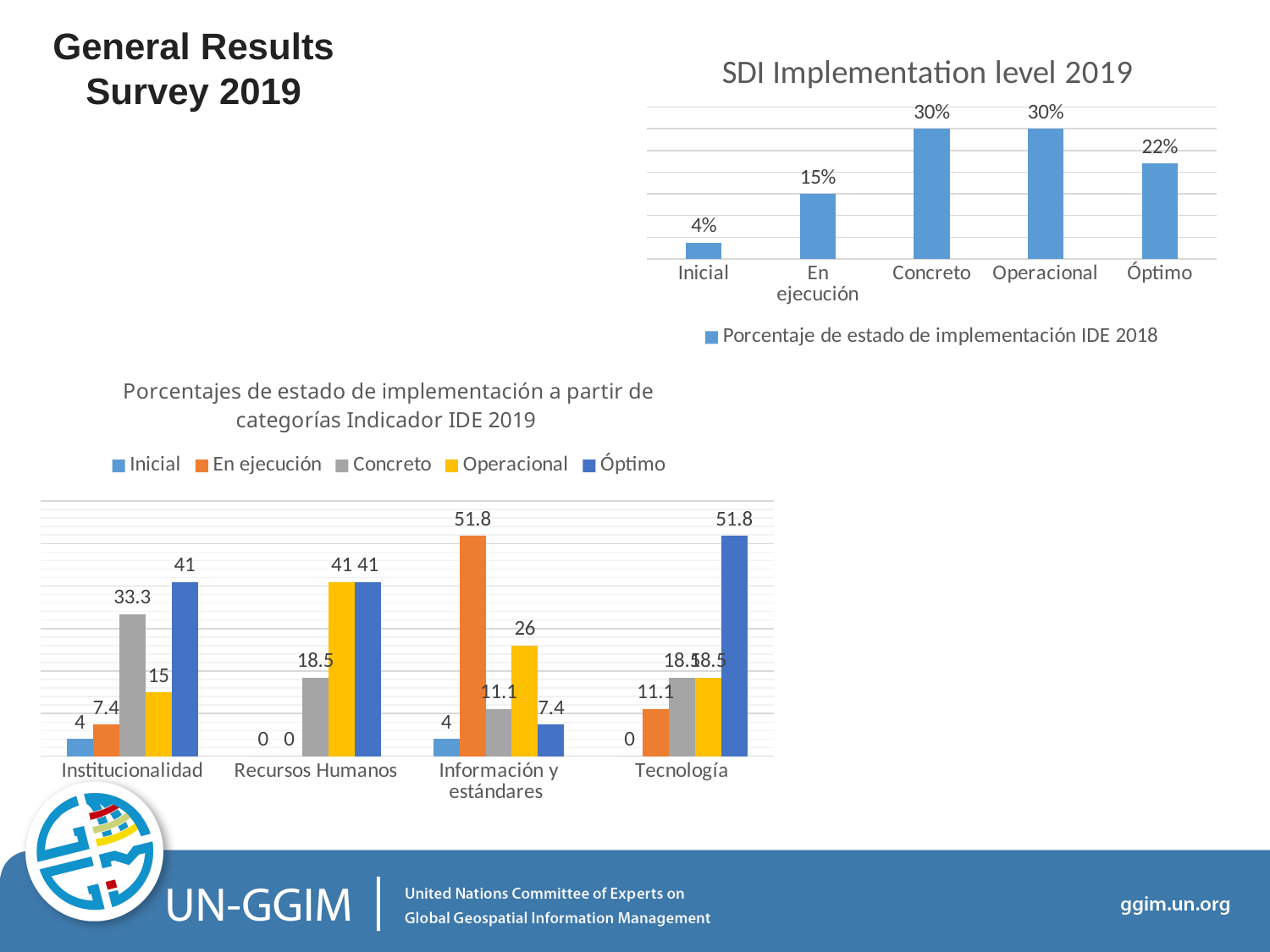
In the 'SDI Implementation level 2019' chart, what is the legend entry? Porcentaje de estado de implementación IDE 2018 In the 'Porcentajes de estado de implementación a partir de categorías Indicador IDE 2019' chart, which is larger for Recursos Humanos: Concreto or Operacional? Operacional In the 'SDI Implementation level 2019' chart, what is the difference between Óptimo and En ejecución? 7% In the 'Porcentajes de estado de implementación a partir de categorías Indicador IDE 2019' chart, what is the value of En ejecución for Información y estándares? 51.8 In the 'Porcentajes de estado de implementación a partir de categorías Indicador IDE 2019' chart, what is the value of Concreto for Institucionalidad? 33.3 In the 'Porcentajes de estado de implementación a partir de categorías Indicador IDE 2019' chart, which series has the highest value for Tecnología? Óptimo In the 'Porcentajes de estado de implementación a partir de categorías Indicador IDE 2019' chart, how many series does the legend list? 5 In the 'Porcentajes de estado de implementación a partir de categorías Indicador IDE 2019' chart, what is the difference between Operacional and Óptimo for Información y estándares? 18.6 In the 'SDI Implementation level 2019' chart, how many categories are shown on the x axis? 5 In the 'SDI Implementation level 2019' chart, what is the value for Concreto? 30% In the 'SDI Implementation level 2019' chart, which category has the lowest value? Inicial What type of chart is the 'Porcentajes de estado de implementación a partir de categorías Indicador IDE 2019' chart? Bar chart